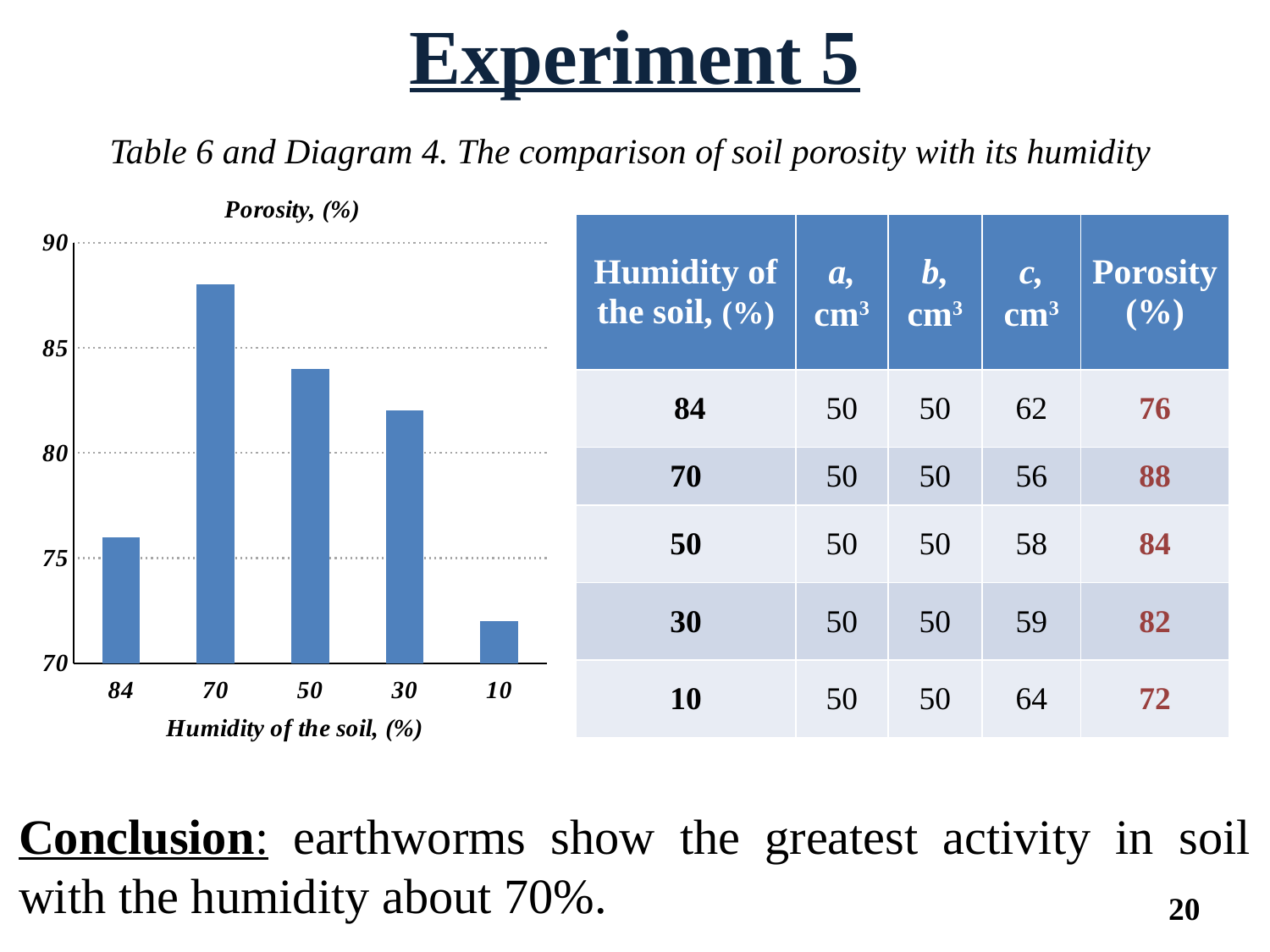
Is the porosity for soil humidity of 84% greater or less than 80? less How many humidity categories are plotted in the bar chart? 5 What is the difference in porosity between soil humidity of 70% and 10%? 16 Which soil humidity value has the highest porosity in the bar chart? 70 What is the porosity for soil humidity of 70%? 88 What kind of chart is shown on the slide? bar chart What is the porosity for soil humidity of 10%? 72 What is the label of the vertical axis of the bar chart? Porosity, (%) Which has the higher porosity: soil humidity of 84% or 30%? 30 Is the porosity for soil humidity of 50% greater or less than 80? greater What is the label of the horizontal axis of the bar chart? Humidity of the soil, (%) Which soil humidity value has the lowest porosity in the bar chart? 10